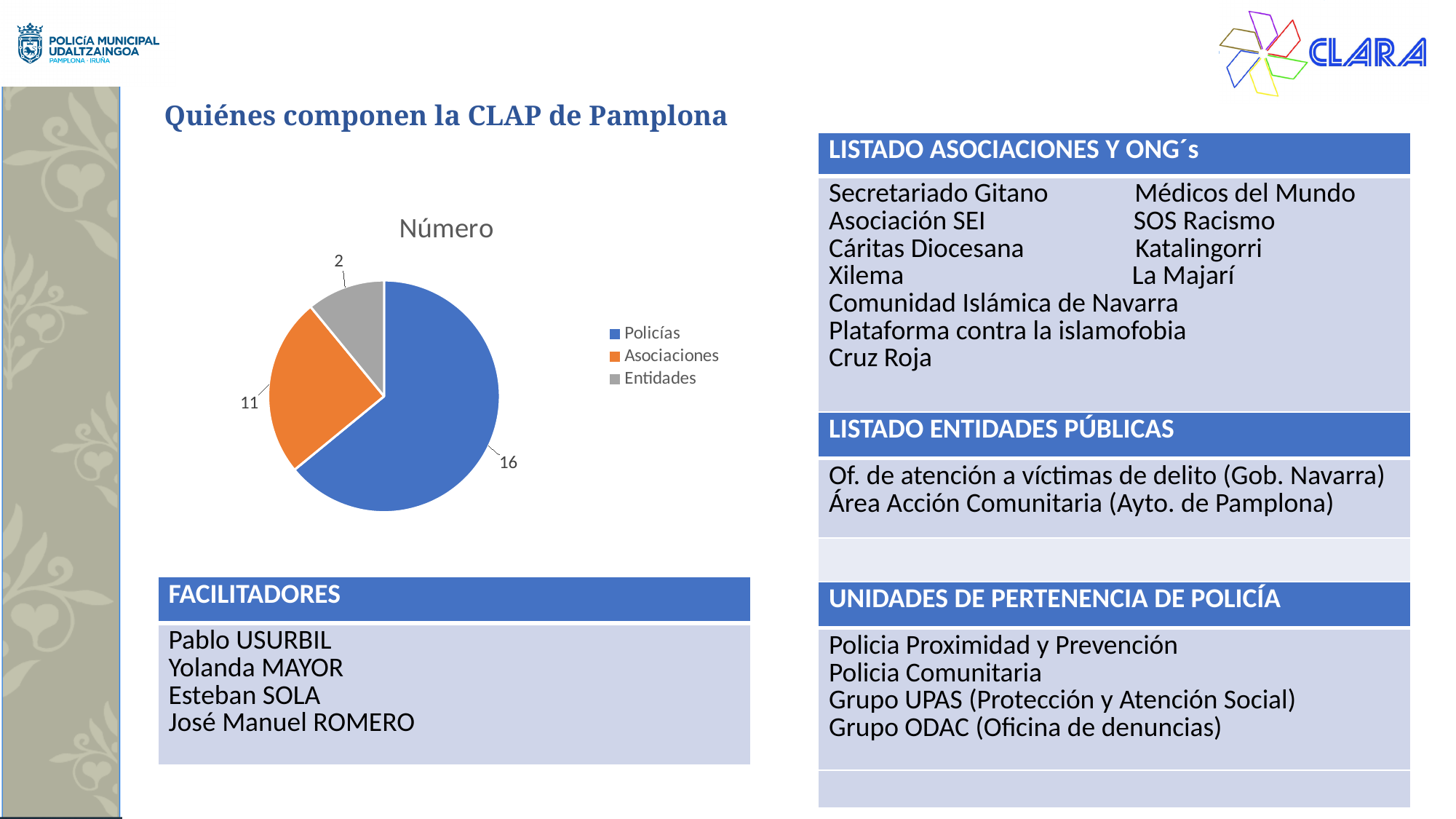
Which colour represents Asociaciones in the chart? orange What is the difference between the values for Policías and Asociaciones? 5 What is the total of all the slices in the chart? 29 Which category has the largest slice in the chart? Policías What is the title of the chart? Número What is the value for Policías in the chart? 16 What is the value for Entidades in the chart? 2 What is the value for Asociaciones in the chart? 11 How many categories does the pie chart have? 3 Which category has the smallest slice in the chart? Entidades Which is larger, the value for Asociaciones or the value for Entidades? Asociaciones What type of chart is shown on the slide? pie chart